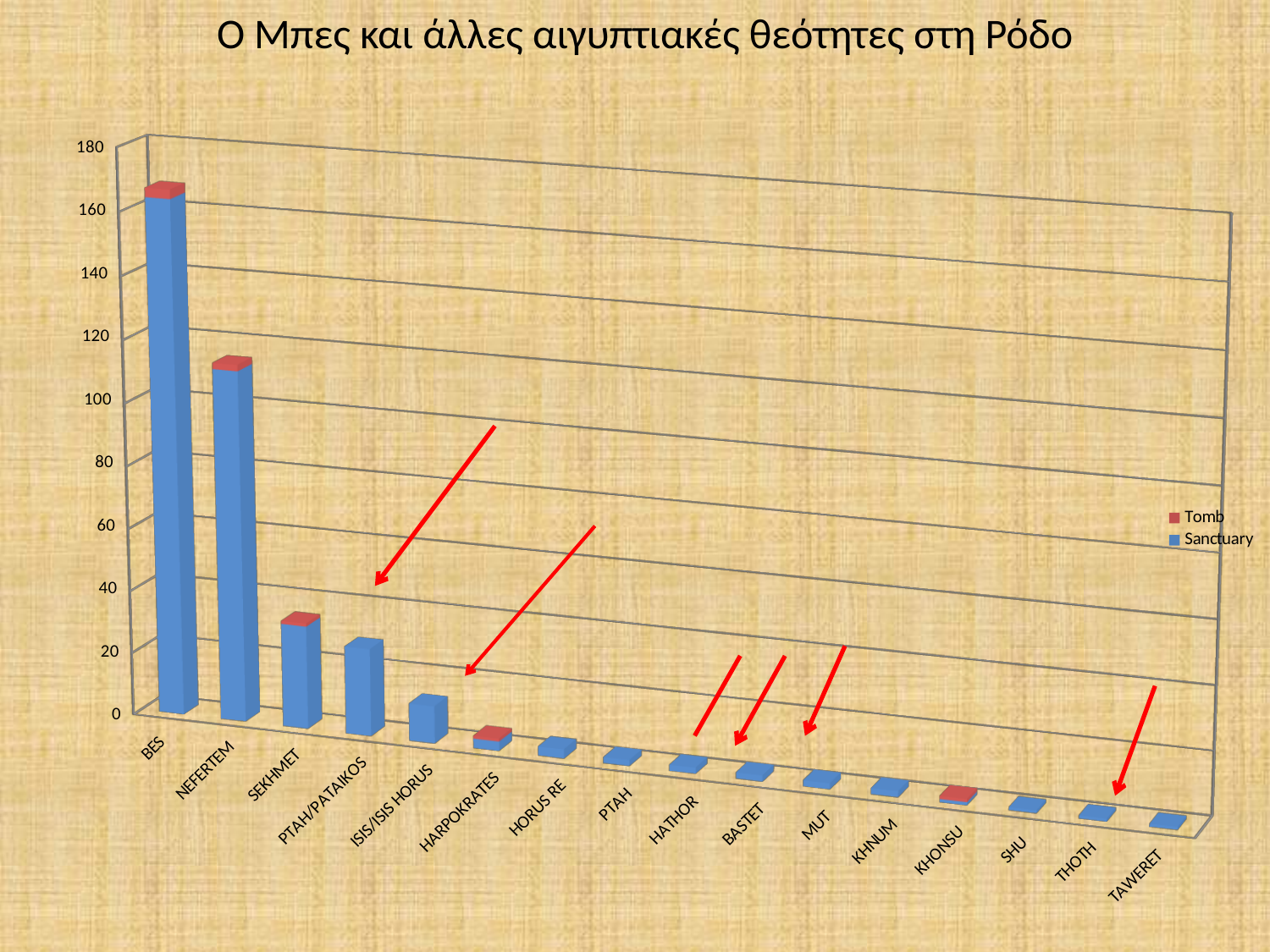
How many series does the chart's legend list? 2 Which category has the highest bar in the chart? BES What are the two series named in the chart's legend? Tomb and Sanctuary How many categories (deities) are shown on the x axis of the chart? 16 Which is larger, the bar for NEFERTEM or the bar for SEKHMET? NEFERTEM Which is larger, the bar for BES or the bar for NEFERTEM? BES Is the value for BES greater or less than 140? greater Do the bar values rise or fall moving from left to right along the x axis? fall Is the value for NEFERTEM greater or less than 80? greater Is the value for SEKHMET greater or less than 60? less What kind of chart is shown on the slide? bar chart